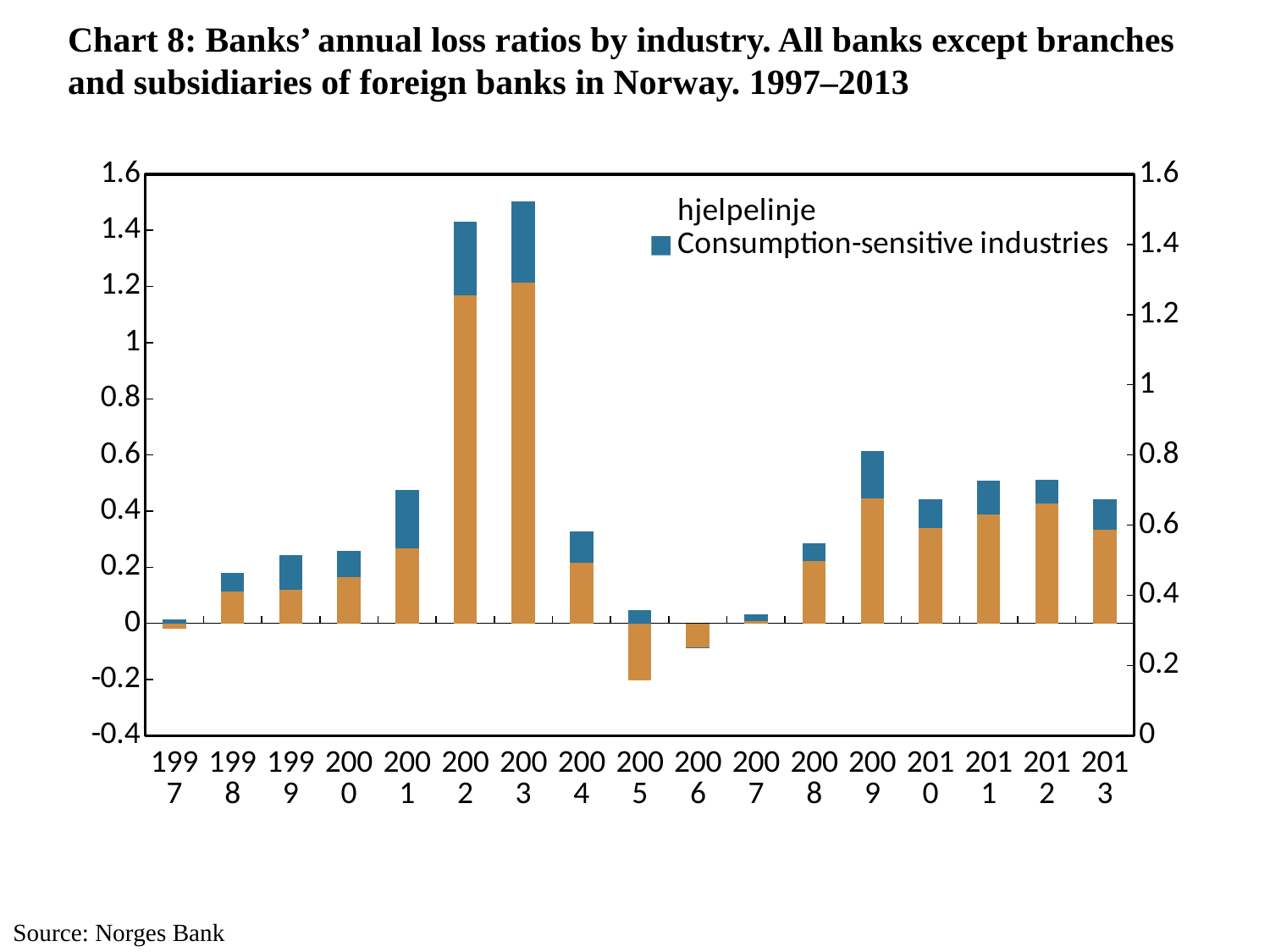
How many years are shown on the x axis of the chart? 17 Is the total stacked value for 2004 greater or less than 0.4? less Is the total stacked value for 2011 greater or less than 0.4? greater Which year has the bar that extends furthest below zero? 2005 Which year has the tallest stacked bar in the chart? 2003 Is the total stacked value for 2002 greater or less than 1.2? greater What is the source given for the chart? Norges Bank What kind of chart is shown on the slide? Stacked bar chart Which year has the larger total stacked bar, 2009 or 2010? 2009 Which year has the larger total stacked bar, 1998 or 1999? 1999 How many entries does the chart's legend list? 2 Do the stacked bar totals rise or fall from 1997 to 2003? rise